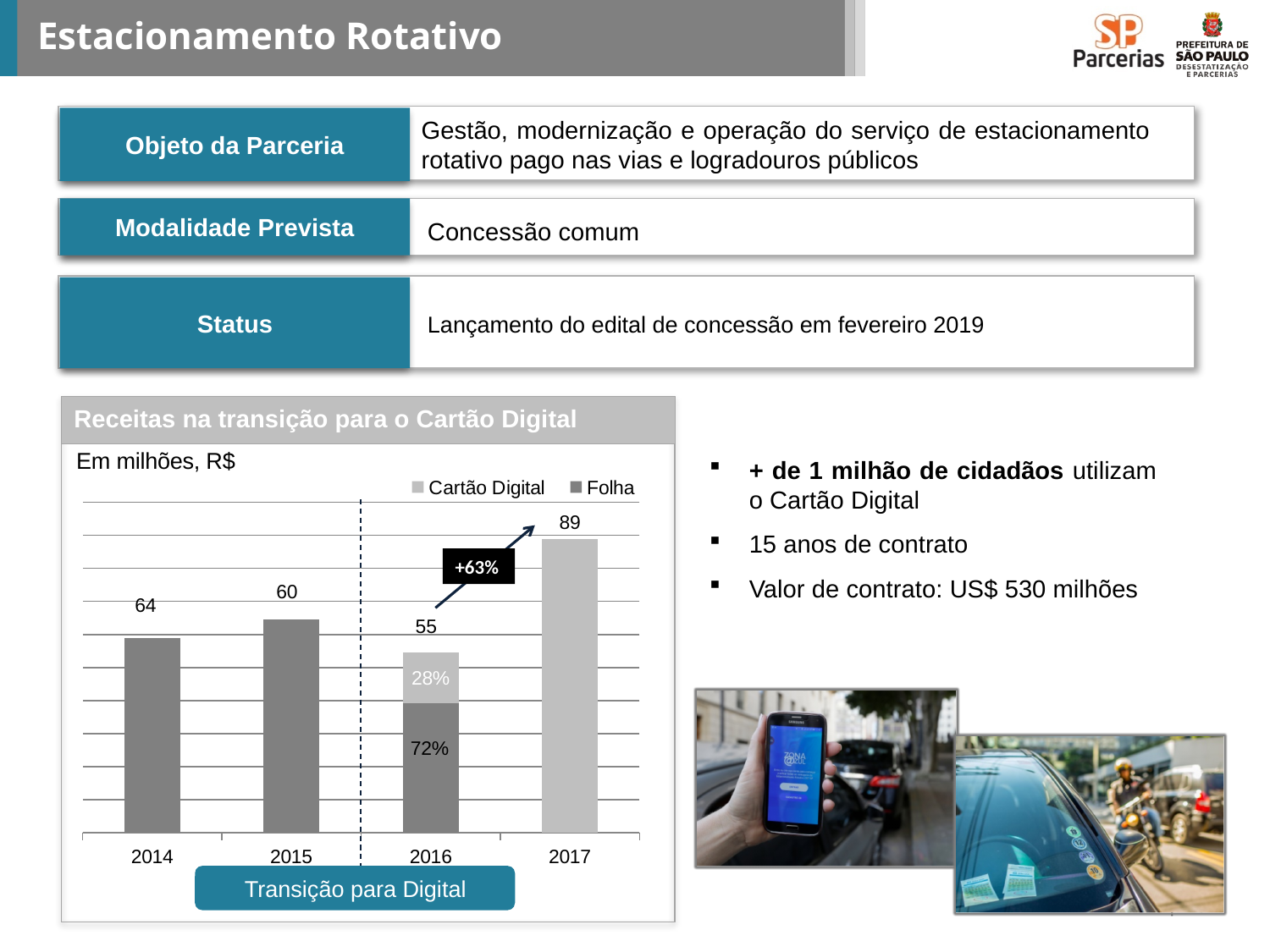
What is the total revenue shown for 2014 in the chart? 64 What percentage of the 2016 bar is labelled as Folha? 72% How many series does the legend of the chart list? 2 What is the difference between the total revenue in 2017 and in 2016? 34 What is the total revenue shown for 2016 in the chart? 55 What kind of chart is 'Receitas na transição para o Cartão Digital'? Bar chart What percentage of the 2016 bar is labelled as Cartão Digital? 28% What is the total revenue shown for 2017 in the chart 'Receitas na transição para o Cartão Digital'? 89 What is the total revenue shown for 2015 in the chart? 60 Which year has the lowest total revenue in the chart? 2016 Which year has the highest total revenue in the chart? 2017